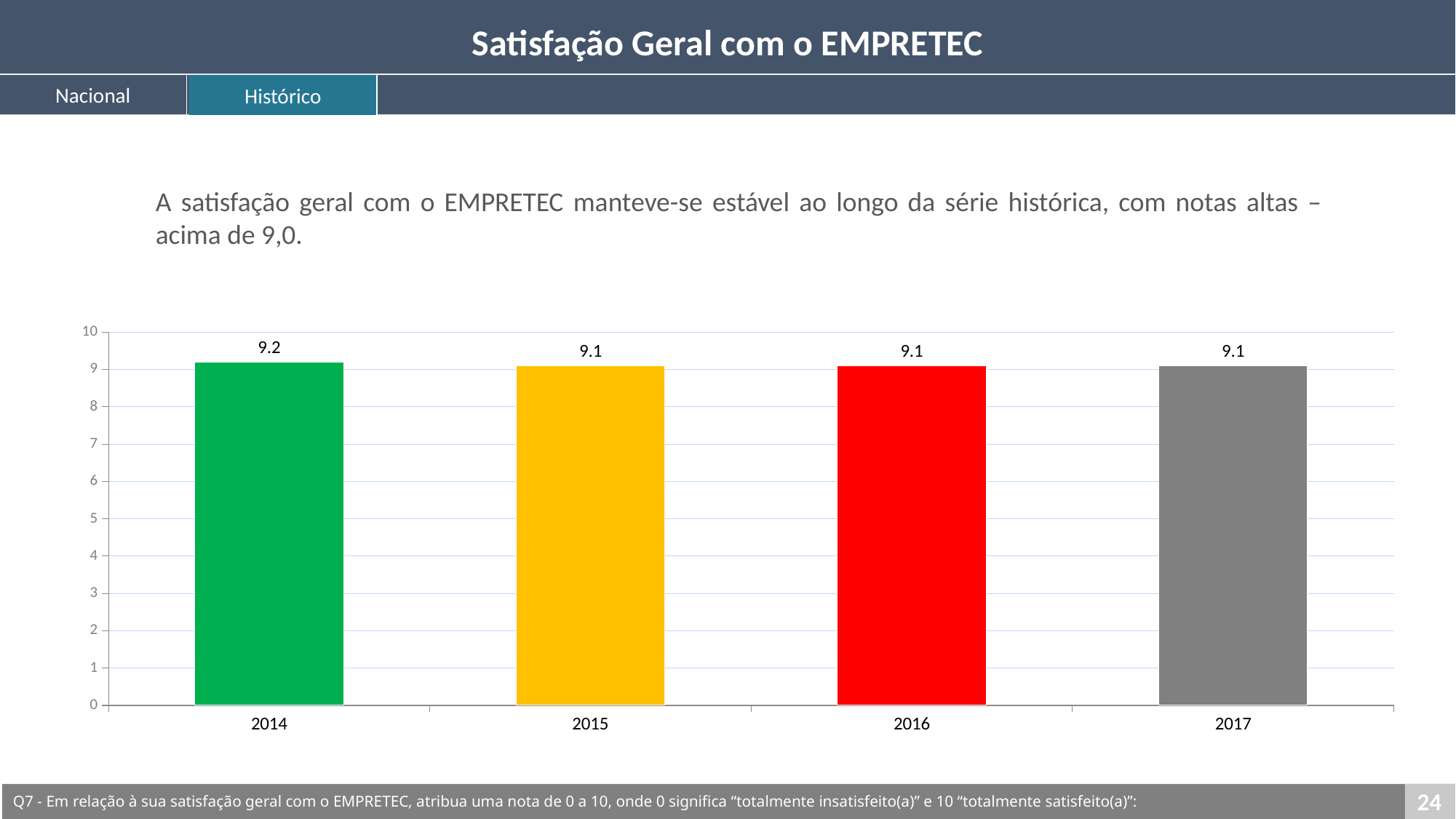
What is the maximum value shown on the y axis? 10 Which year has the highest value? 2014 Do the values rise, fall or stay roughly stable from 2015 to 2017? stay stable What is the value for 2015? 9.1 What is the value for 2014? 9.2 What is the difference between the values for 2014 and 2016? 0.1 What colour is the bar for 2016? red Which is larger, the value for 2014 or the value for 2015? 2014 What kind of chart is shown on the slide? bar chart Is the value for 2016 greater or less than 5? greater How many years are shown on the x axis? 4 What is the value for 2017? 9.1